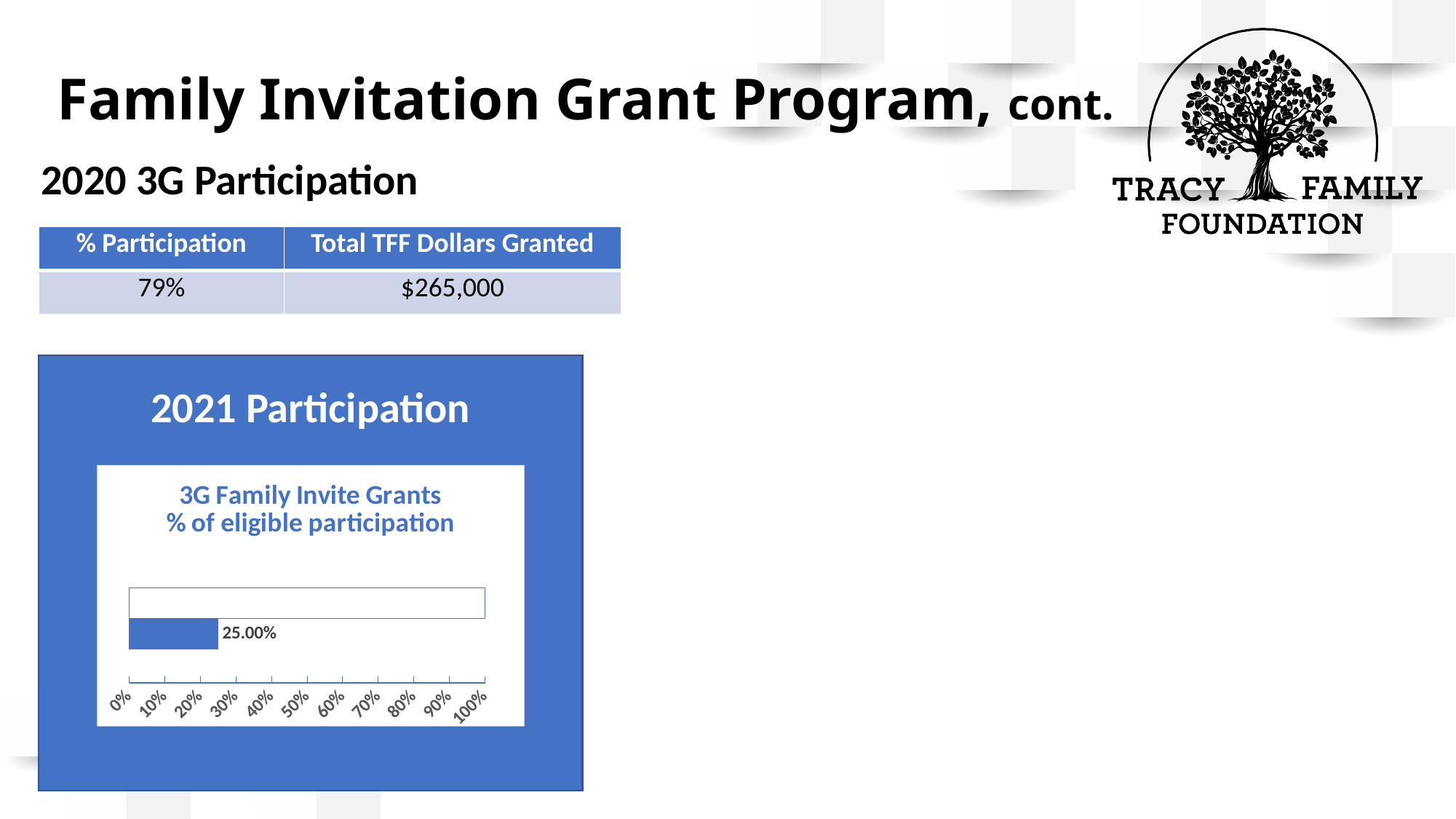
Are the bars in the "3G Family Invite Grants % of eligible participation" chart horizontal or vertical? horizontal In the "3G Family Invite Grants % of eligible participation" chart, is the filled bar's value greater or less than 20%? greater What value is printed on the filled bar in the "3G Family Invite Grants % of eligible participation" chart? 25.00% How many tick labels are shown on the x axis of the "3G Family Invite Grants % of eligible participation" chart? 11 In the "3G Family Invite Grants % of eligible participation" chart, is the filled bar's value greater or less than 50%? less In the "3G Family Invite Grants % of eligible participation" chart, is the filled bar's value greater or less than 30%? less What kind of chart is shown under the heading "2021 Participation"? bar chart What is the title of the chart on the slide? 3G Family Invite Grants % of eligible participation What is the highest value labelled on the x axis of the "3G Family Invite Grants % of eligible participation" chart? 100%